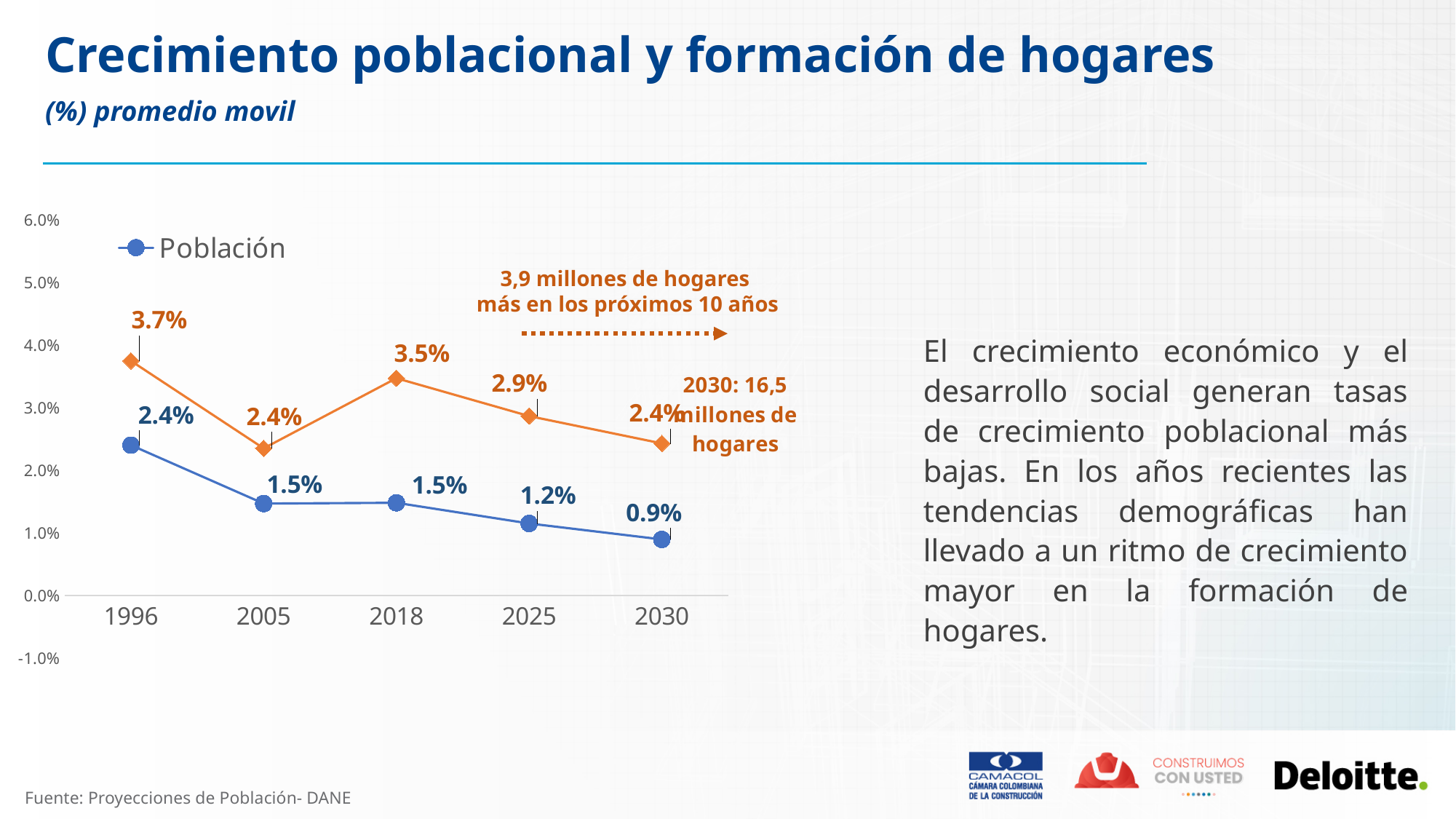
Does the Población line generally rise or fall from 1996 to 2030? fall In which year is the Población value lowest? 2030 What is the value of the orange line for 2005? 2.4% What is the difference between the orange line value and the Población value in 2025? 1.7% How many years are plotted on the x axis? 5 In which year is the orange line at its highest value? 1996 What is the Población value for 1996? 2.4% Which is larger in 2030: the orange line value or the Población value? the orange line value What is the Población value for 2030? 0.9% What is the value of the orange line for 2018? 3.5% How many series does the legend list? 1 What type of chart is shown on the slide? line chart